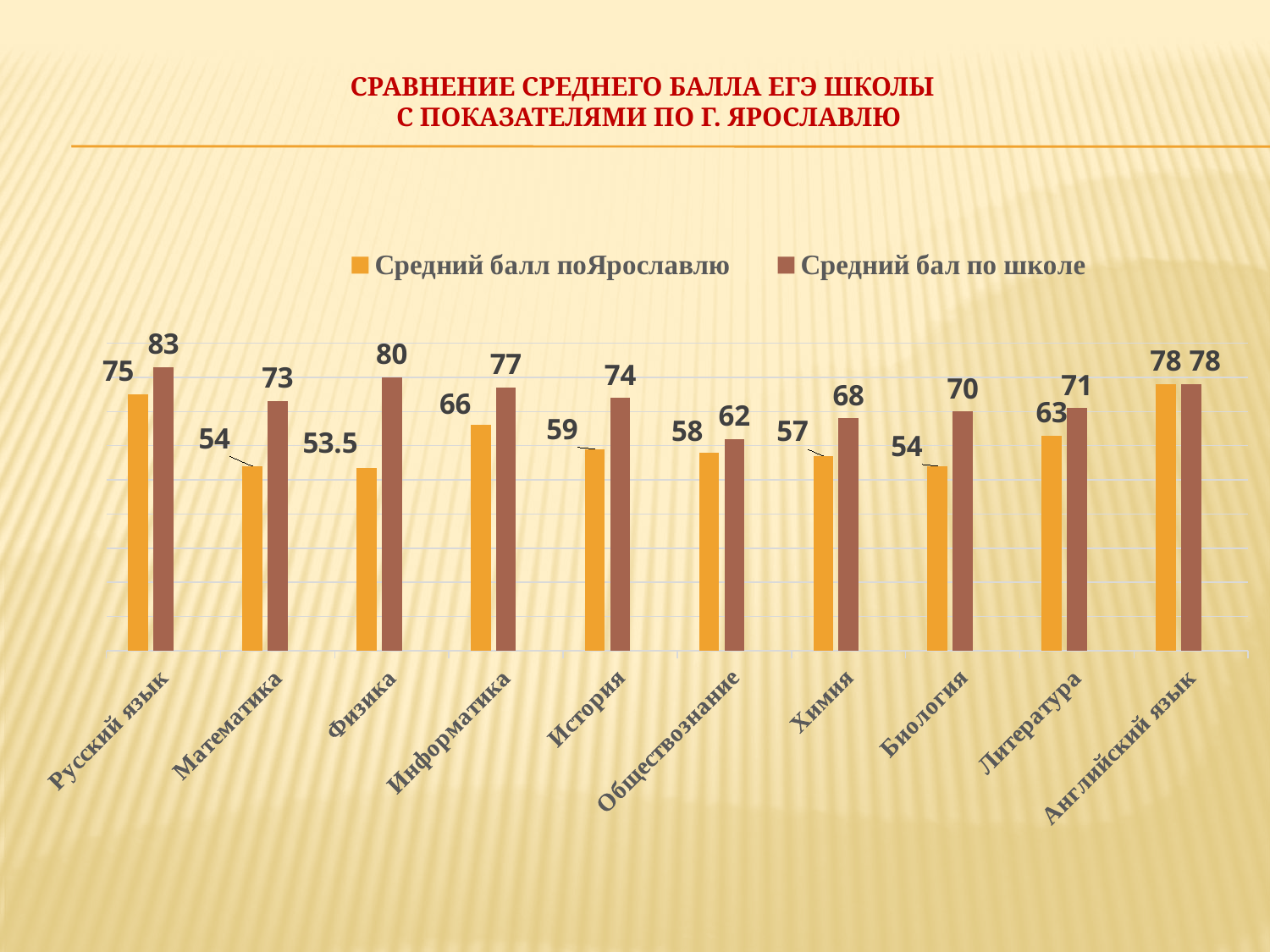
Which series is shown in orange in the legend? Средний балл по Ярославлю Which is larger for Информатика: 'Средний балл по Ярославлю' or 'Средний бал по школе'? Средний бал по школе Which subject has the highest value for 'Средний бал по школе'? Русский язык What is the value of 'Средний бал по школе' for Русский язык? 83 What is the difference between the school average and the Yaroslavl average for Математика? 19 What is the difference between the school average and the Yaroslavl average for Физика? 26.5 How many series does the legend list? 2 How many subjects (categories) are shown on the x axis? 10 What is the value of 'Средний бал по школе' for Биология? 70 What is the value of 'Средний балл по Ярославлю' for Физика? 53.5 What kind of chart is shown on the slide? bar chart Which subject has the lowest value for 'Средний балл по Ярославлю'? Физика